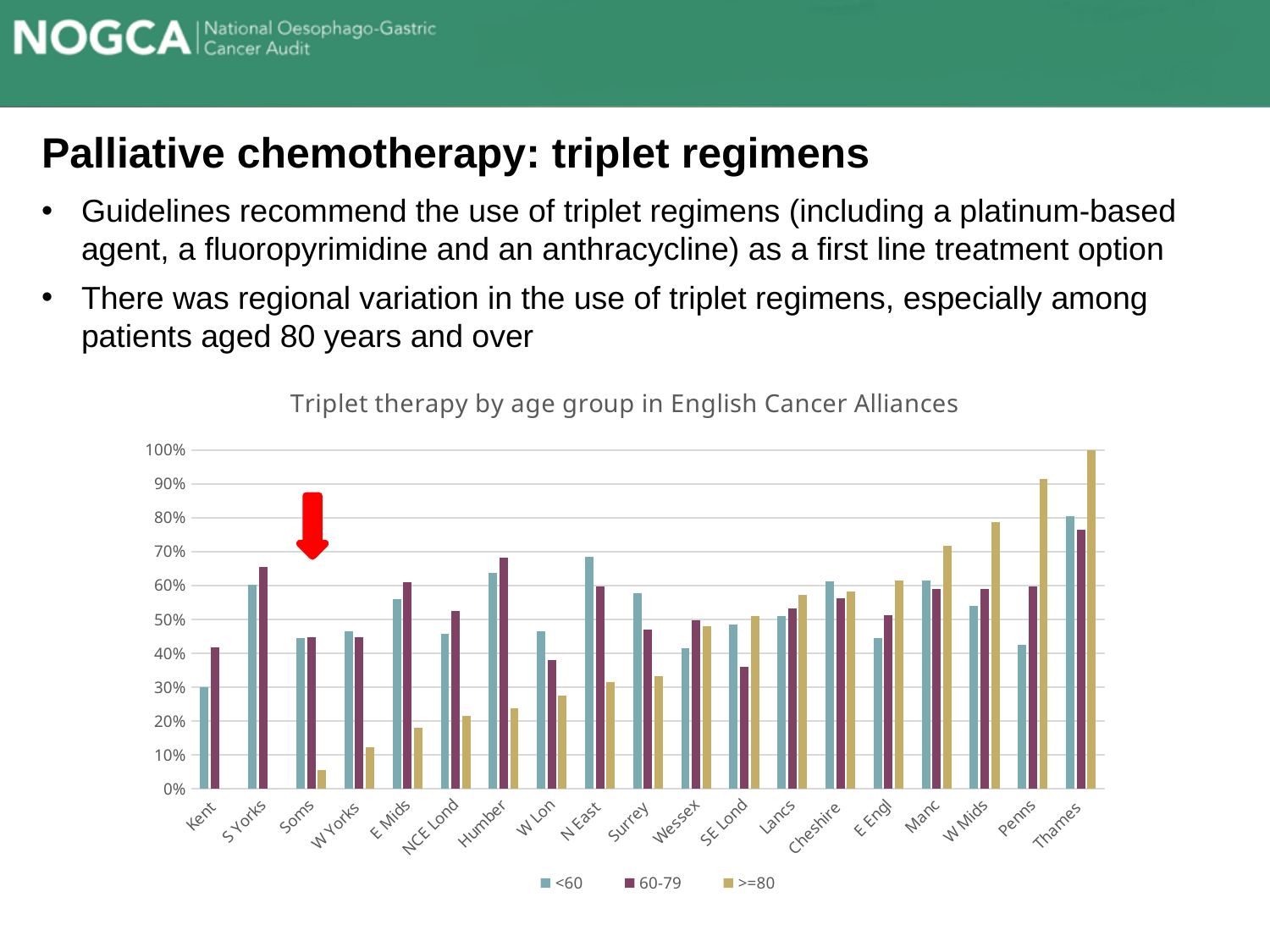
Do the values for the >=80 series generally rise or fall from left to right along the x axis? Rise Is the value for the >=80 series for Soms greater or less than 10%? less How many cancer alliances are shown on the x axis? 19 Which cancer alliance has the lowest value for the <60 series? Kent What is the value for the >=80 series for Thames? 100% How many series does the legend list? 3 What type of chart is shown on the slide? Bar chart For Penns, which is larger: the <60 value or the >=80 value? >=80 Which cancer alliance has the highest value for the >=80 series? Thames What is the title of the chart? Triplet therapy by age group in English Cancer Alliances Is the value for the >=80 series for W Mids greater or less than 70%? greater